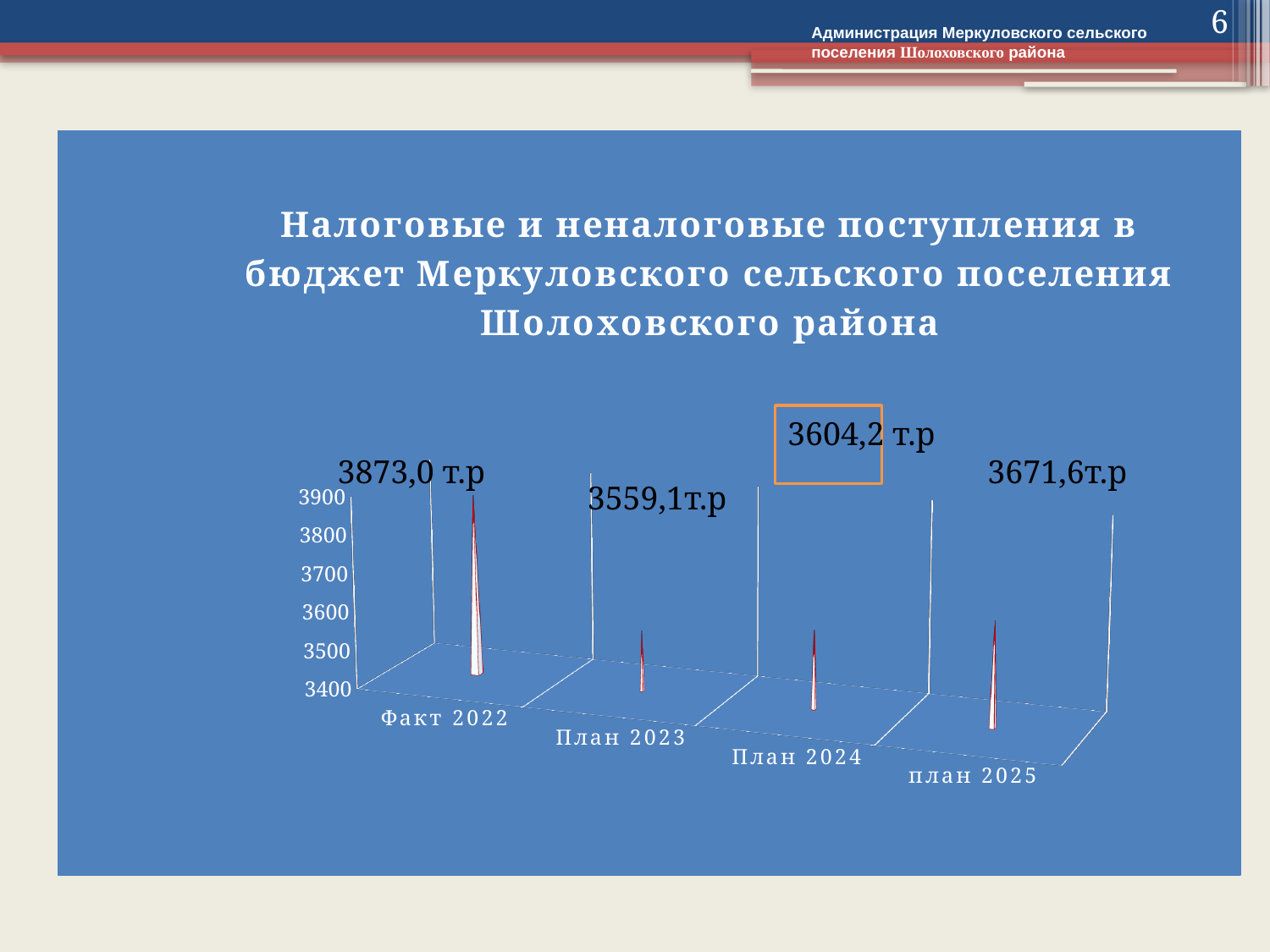
Is the value for Факт 2022 greater or less than 3800? greater Which category has the lowest value? План 2023 Which is larger, the value for План 2024 or the value for план 2025? план 2025 What is the value for Факт 2022? 3873,0 т.р How many categories are shown on the x axis? 4 Do the values rise or fall from План 2023 to план 2025? rise What is the value for План 2024? 3604,2 т.р What is the value for план 2025? 3671,6т.р What is the value for План 2023? 3559,1т.р What is the difference between the values for Факт 2022 and План 2023? 313,9 т.р Which category has the highest value? Факт 2022 What is the difference between the values for план 2025 and План 2024? 67,4 т.р